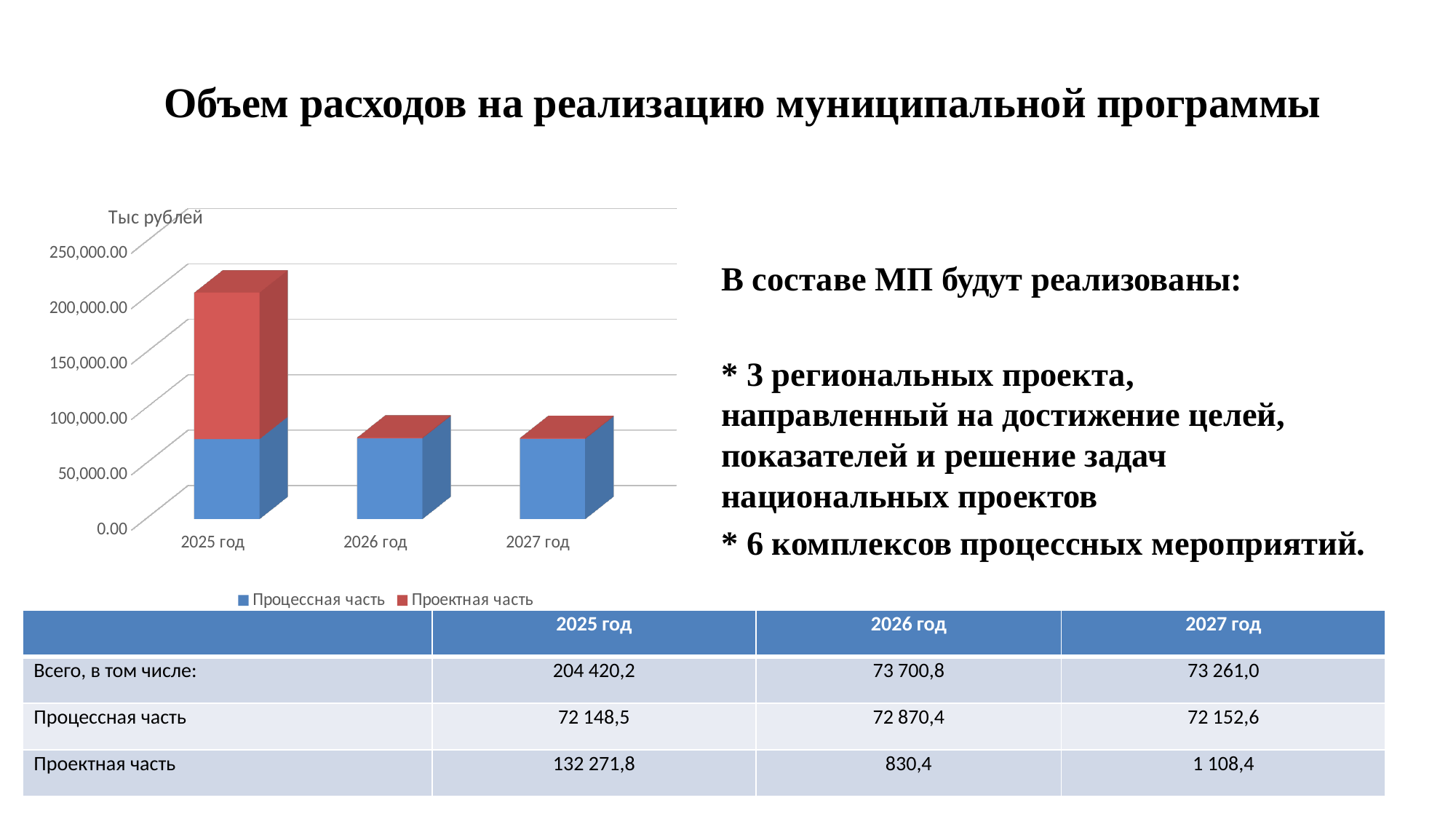
What is the difference between the total for 2025 год and the total for 2026 год? 130 719,4 What is the total of the stacked bar for 2027 год? 73 261,0 Is the total value for 2025 год greater or less than 150,000.00? greater What is the value of Процессная часть for 2026 год? 72 870,4 What unit label is shown at the top of the chart's vertical axis? Тыс рублей How many series does the chart legend list? 2 What kind of chart is shown on the slide? bar chart How many years (categories) are shown on the x axis of the chart? 3 Which year has the highest total bar in the chart? 2025 год What is the value of Проектная часть for 2025 год? 132 271,8 Is the total value for 2026 год greater or less than 100,000.00? less Which year has the larger Проектная часть value, 2025 год or 2027 год? 2025 год